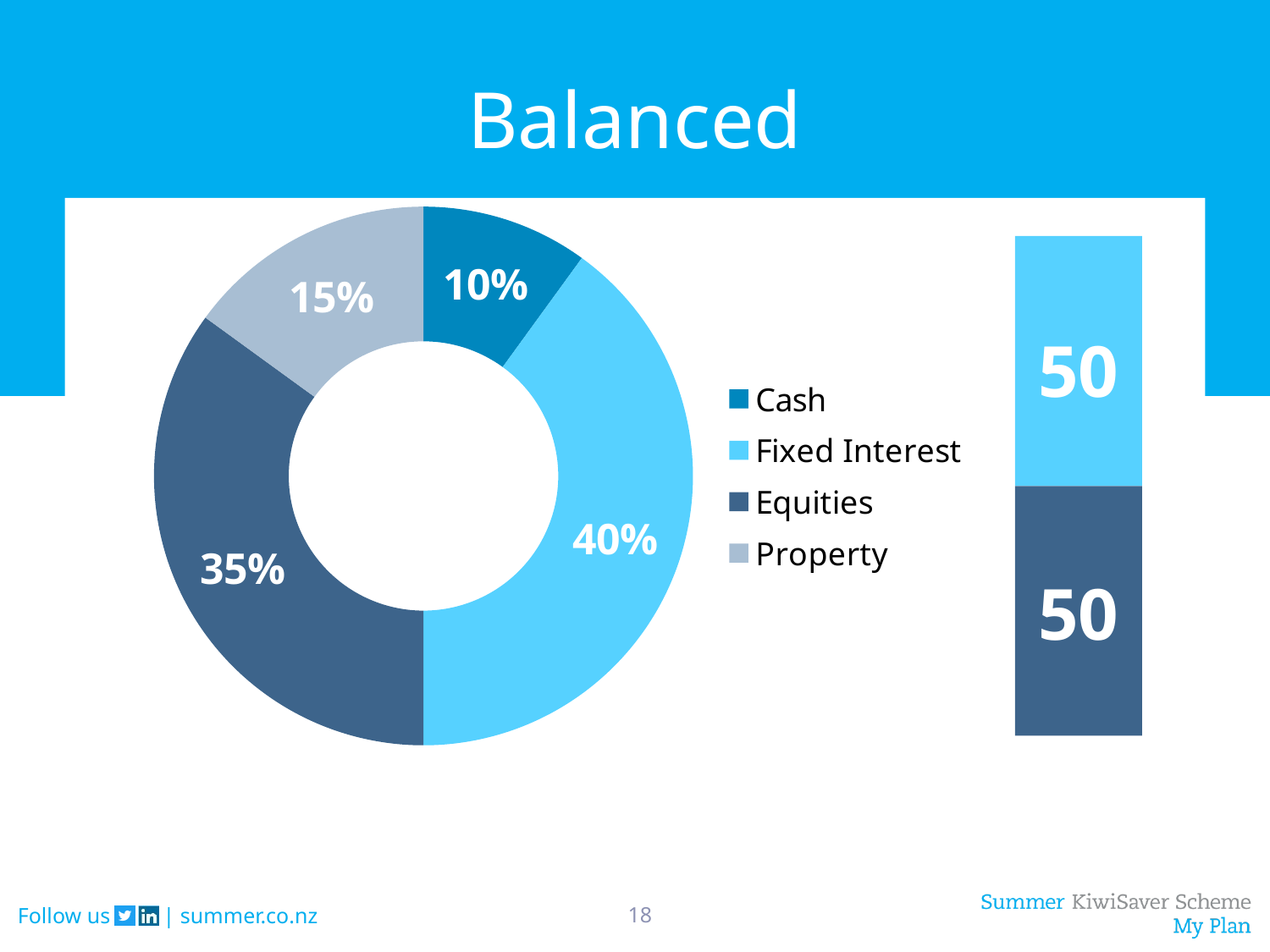
In the donut chart, what is the difference between the Fixed Interest and Equities shares? 5% In the donut chart, what percentage is Fixed Interest? 40% In the donut chart, what percentage is Cash? 10% In the donut chart, what percentage is Property? 15% What kind of chart is the chart on the left of the slide? Donut (pie) chart What is the title of the slide containing the donut chart? Balanced How many categories does the donut chart's legend list? 4 In the donut chart, which category has the smallest share? Cash In the donut chart, what percentage is Equities? 35% In the donut chart, which category has the largest share? Fixed Interest In the donut chart, which is larger, Property or Cash? Property In the stacked bar on the right of the slide, what is the total of the two segments? 100